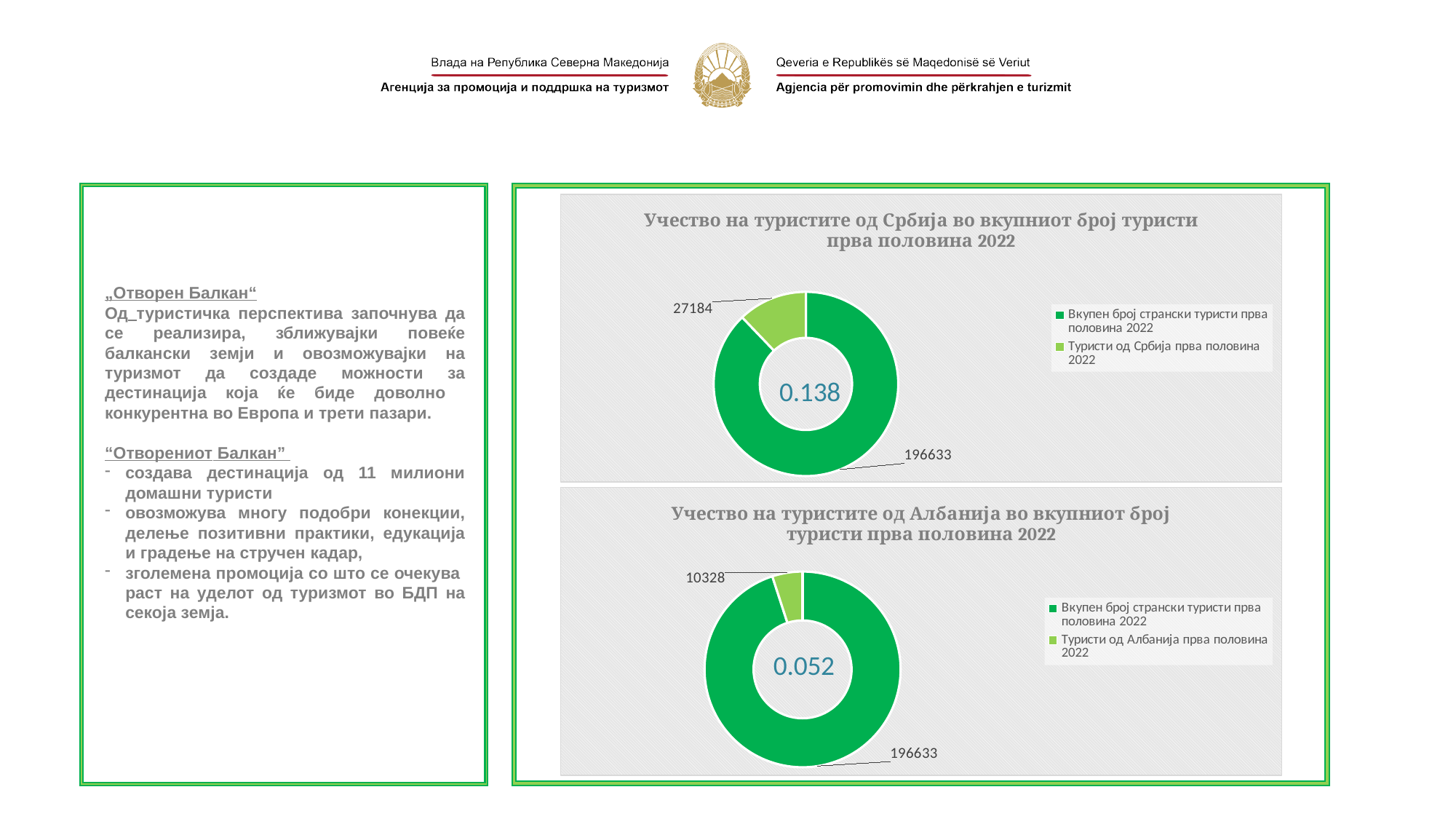
In the bottom chart (Учество на туристите од Албанија), what value is shown for Туристи од Албанија прва половина 2022? 10328 In the top chart (Учество на туристите од Србија), what is the difference between the value for Вкупен број странски туристи and the value for Туристи од Србија? 169449 What number is printed in the centre of the bottom chart (Учество на туристите од Албанија)? 0.052 In the bottom chart (Учество на туристите од Албанија), what is the difference between the value for Вкупен број странски туристи and the value for Туристи од Албанија? 186305 What number is printed in the centre of the top chart (Учество на туристите од Србија)? 0.138 Which is larger: the value for Туристи од Србија in the top chart or the value for Туристи од Албанија in the bottom chart? Туристи од Србија (27184) How many entries does the legend of the bottom chart (Учество на туристите од Албанија) list? 2 In the top chart (Учество на туристите од Србија), which slice is the largest? Вкупен број странски туристи прва половина 2022 In the top chart (Учество на туристите од Србија), what value is shown for Вкупен број странски туристи прва половина 2022? 196633 What kind of chart is the top chart (Учество на туристите од Србија)? Doughnut (pie) chart In the bottom chart (Учество на туристите од Албанија), what value is shown for Вкупен број странски туристи прва половина 2022? 196633 In the top chart (Учество на туристите од Србија), what value is shown for Туристи од Србија прва половина 2022? 27184